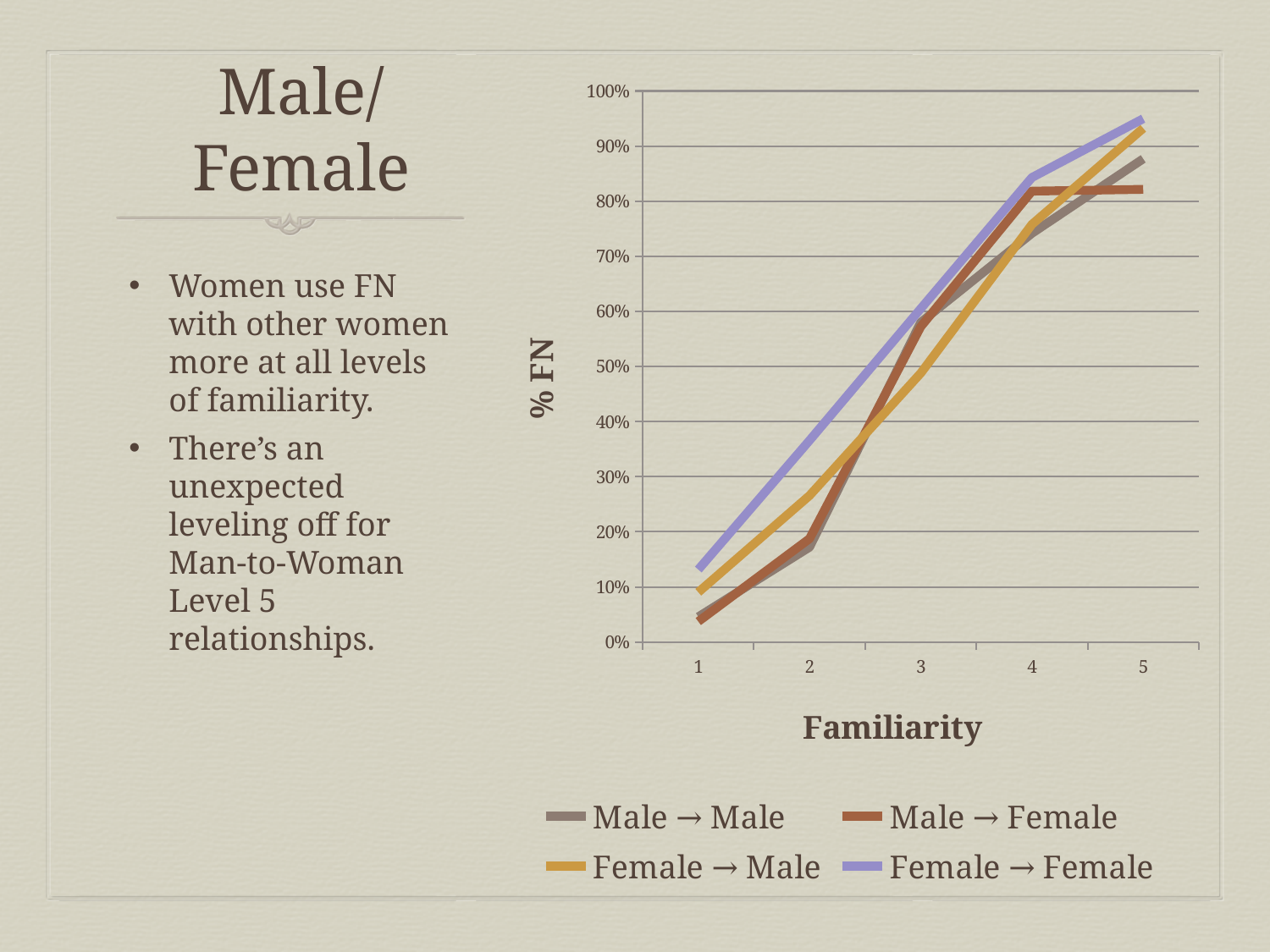
Does the Female → Female line rise or fall as familiarity increases from 1 to 5? rise Is the value for Male → Male at familiarity level 1 greater or less than 10%? less Is the value for Female → Female at familiarity level 5 greater or less than 90%? greater Is the value for Female → Female at familiarity level 2 greater or less than 30%? greater What is the title of the y axis? % FN At familiarity level 5, which is larger: Female → Female or Male → Female? Female → Female Which series has the highest value at familiarity level 1? Female → Female Which series has the lowest value at familiarity level 5? Male → Female How many familiarity levels are plotted along the x axis? 5 How many series does the legend list? 4 What kind of chart is shown on the slide? line chart